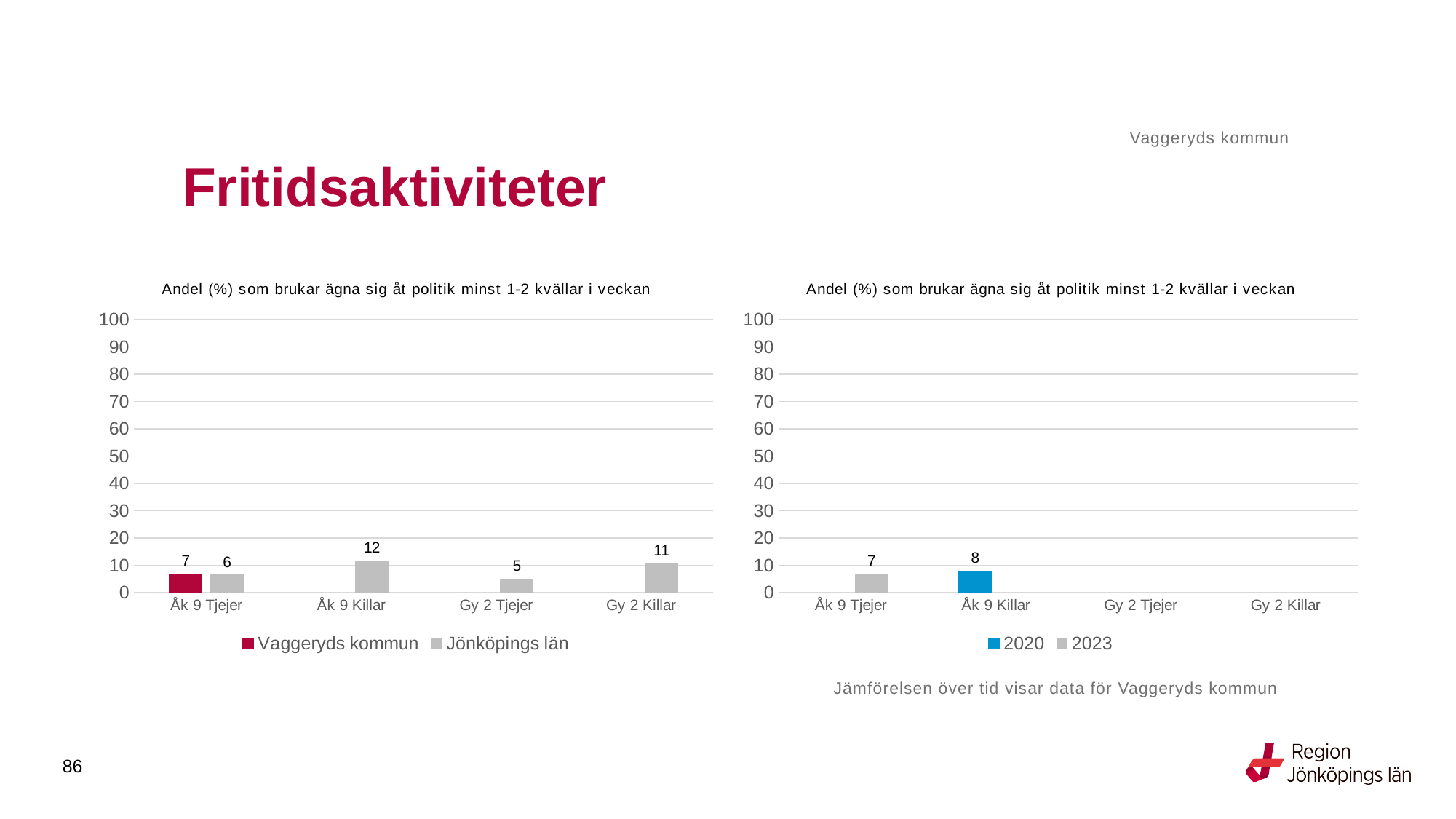
In the left chart, which category has the lowest value for Jönköpings län? Gy 2 Tjejer In the left chart, what is the difference between the Jönköpings län values for Åk 9 Killar and Gy 2 Killar? 1 In the left chart, for Åk 9 Tjejer, which is larger: Vaggeryds kommun or Jönköpings län? Vaggeryds kommun In the right chart, what kind of chart is shown? Bar chart In the right chart, what is the value for 2023 for Åk 9 Tjejer? 7 In the left chart, which category has the highest value for Jönköpings län? Åk 9 Killar In the left chart, what is the value for Vaggeryds kommun for Åk 9 Tjejer? 7 In the left chart, what is the value for Jönköpings län for Åk 9 Killar? 12 In the left chart, how many series does the legend list? 2 In the right chart, what is the value for 2020 for Åk 9 Killar? 8 In the right chart, which series is shown in blue? 2020 In the left chart, what is the value for Jönköpings län for Gy 2 Tjejer? 5